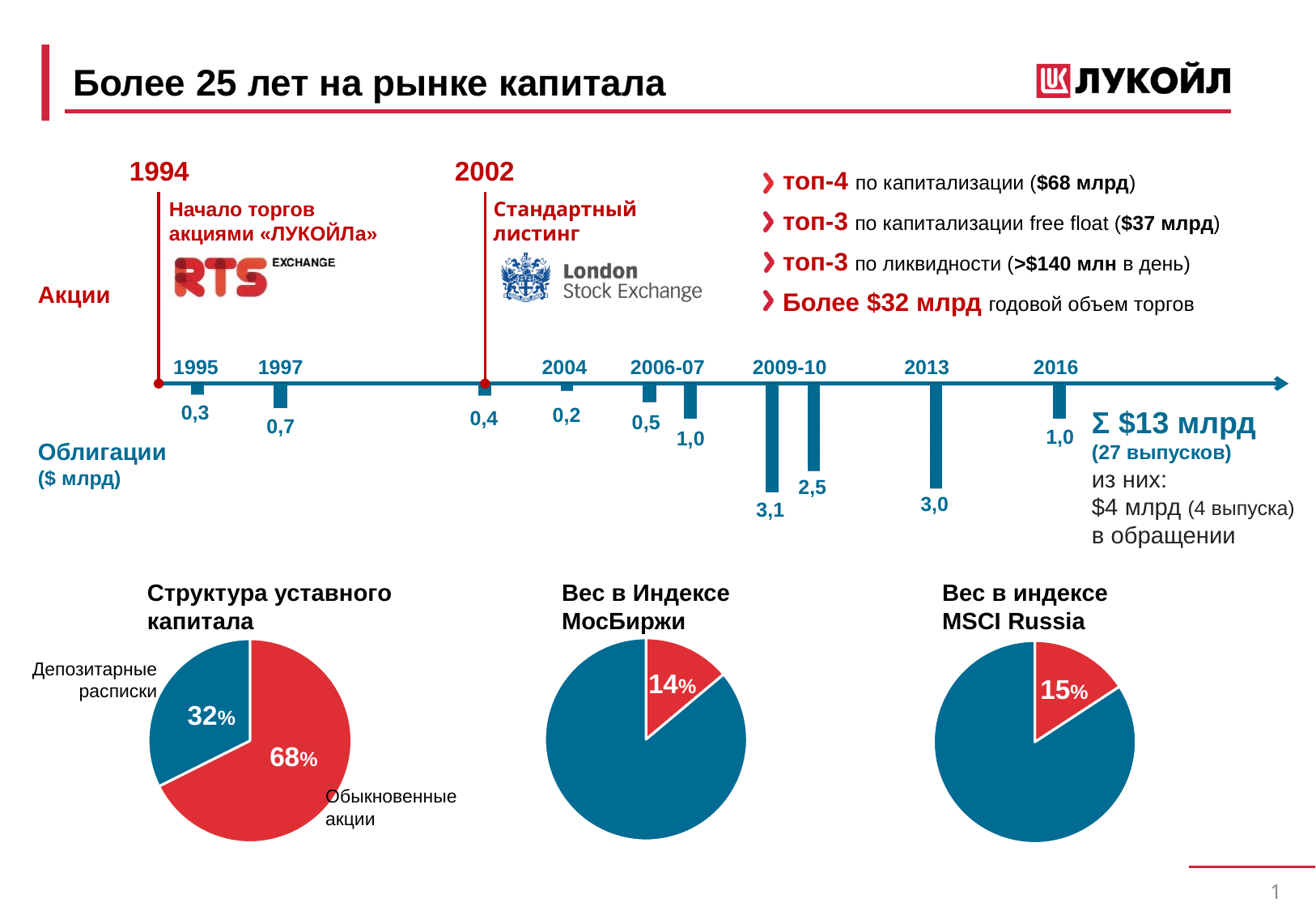
In the 'Структура уставного капитала' pie chart, what share is labelled 'Депозитарные расписки'? 32% How many pie charts are shown on the slide? 3 In the 'Структура уставного капитала' pie chart, what share is labelled 'Обыкновенные акции'? 68% What type of chart is used for 'Структура уставного капитала'? pie chart Which is larger: the red slice in the 'Вес в Индексе МосБиржи' pie or the red slice in the 'Вес в индексе MSCI Russia' pie? Вес в индексе MSCI Russia In the 'Облигации ($ млрд)' bar chart on the timeline, what value is shown for 2013? 3,0 In the 'Вес в индексе MSCI Russia' pie chart, what percentage is shown for the red slice? 15% In the 'Вес в Индексе МосБиржи' pie chart, what percentage is shown for the red slice? 14% What is the difference between the two slices in the 'Структура уставного капитала' pie chart? 36% In the 'Облигации ($ млрд)' bar chart on the timeline, what is the smallest bond issue value shown? 0,2 In the 'Облигации ($ млрд)' bar chart on the timeline, what value is shown for 1997? 0,7 In the 'Облигации ($ млрд)' bar chart on the timeline, what is the largest bond issue value shown? 3,1